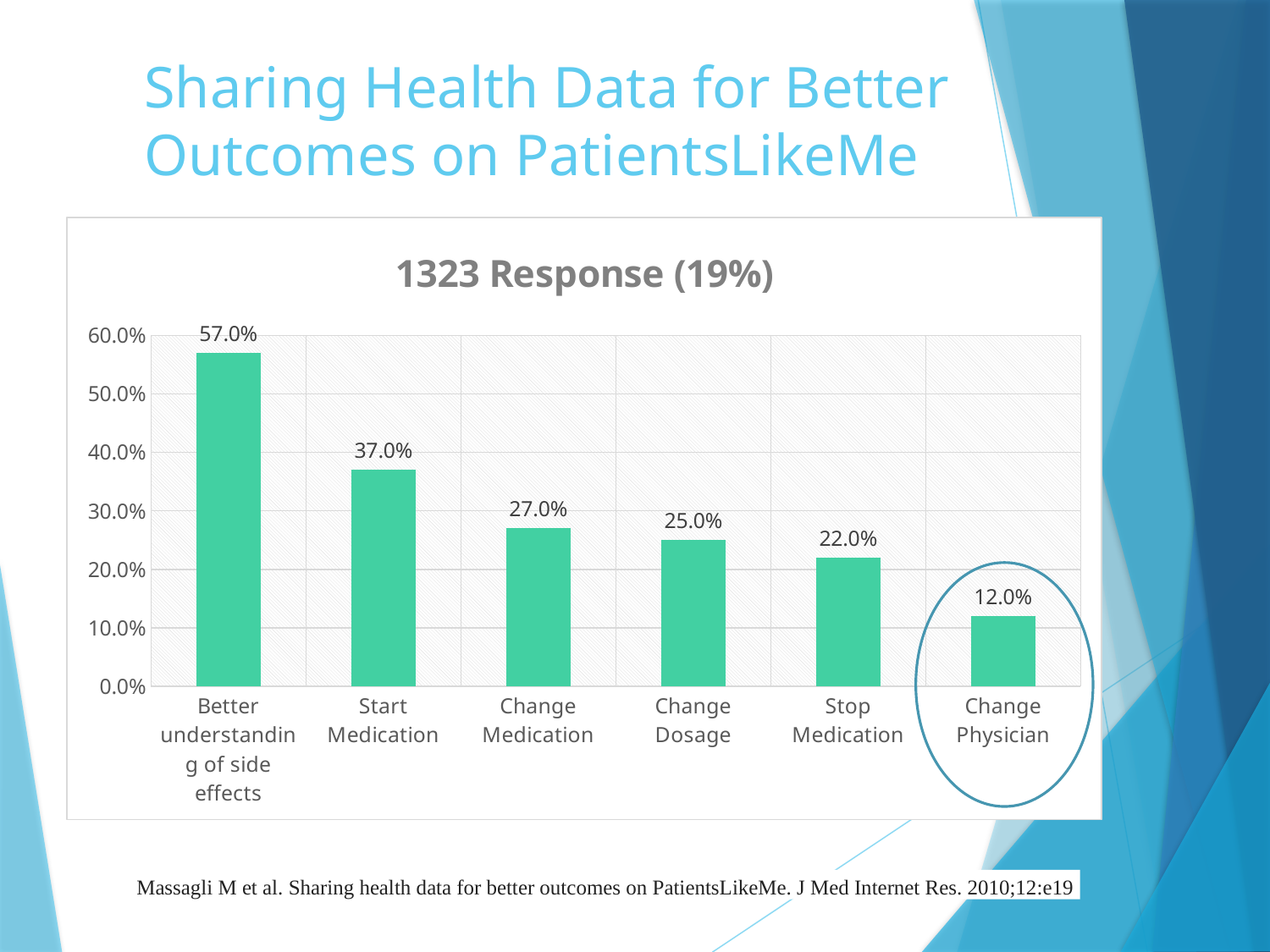
How many categories are shown on the x axis? 6 What is the value for Stop Medication? 22.0% What is the difference between the values for Better understanding of side effects and Start Medication? 20.0% What is the value for Change Physician? 12.0% Which category has the lowest value? Change Physician What is the title of the chart? 1323 Response (19%) Which is larger, the value for Change Dosage or the value for Stop Medication? Change Dosage Is the value for Change Medication greater or less than 20.0%? greater What kind of chart is shown on the slide? bar chart What is the difference between the values for Change Medication and Change Dosage? 2.0% What is the value for Start Medication? 37.0% Which category has the highest value? Better understanding of side effects